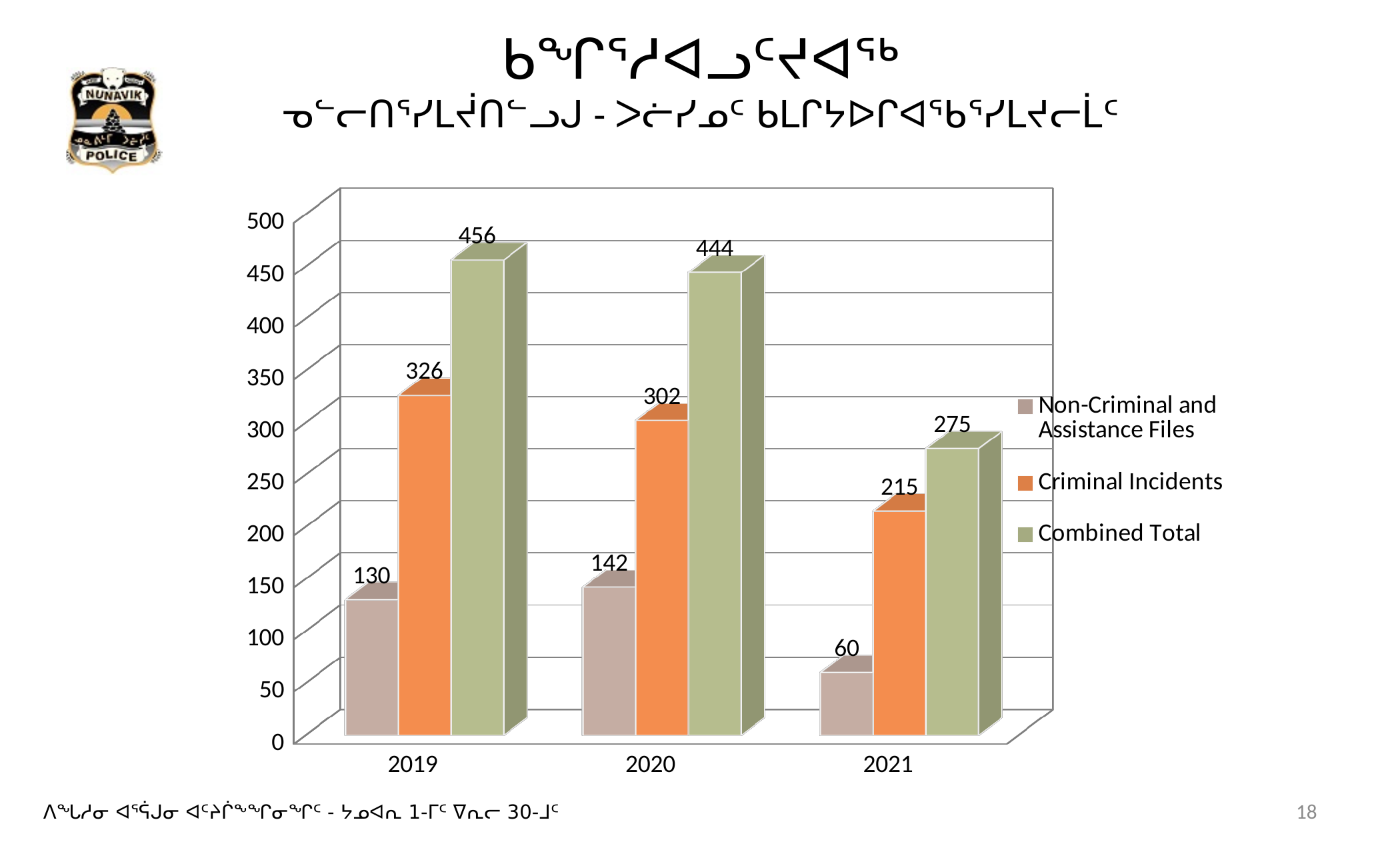
What is the difference between the Combined Total in 2019 and 2020? 12 Which year has the highest Combined Total? 2019 Which year has the lowest value for Criminal Incidents? 2021 What is the Combined Total for 2020? 444 Does the Combined Total rise or fall from 2019 to 2021? fall Which is larger: Non-Criminal and Assistance Files in 2019 or in 2020? 2020 What is the value for Non-Criminal and Assistance Files in 2021? 60 What is the value for Criminal Incidents in 2019? 326 What is the difference between Criminal Incidents in 2019 and 2021? 111 How many series does the legend list? 3 What kind of chart is shown on the slide? bar chart How many years are shown on the x axis? 3